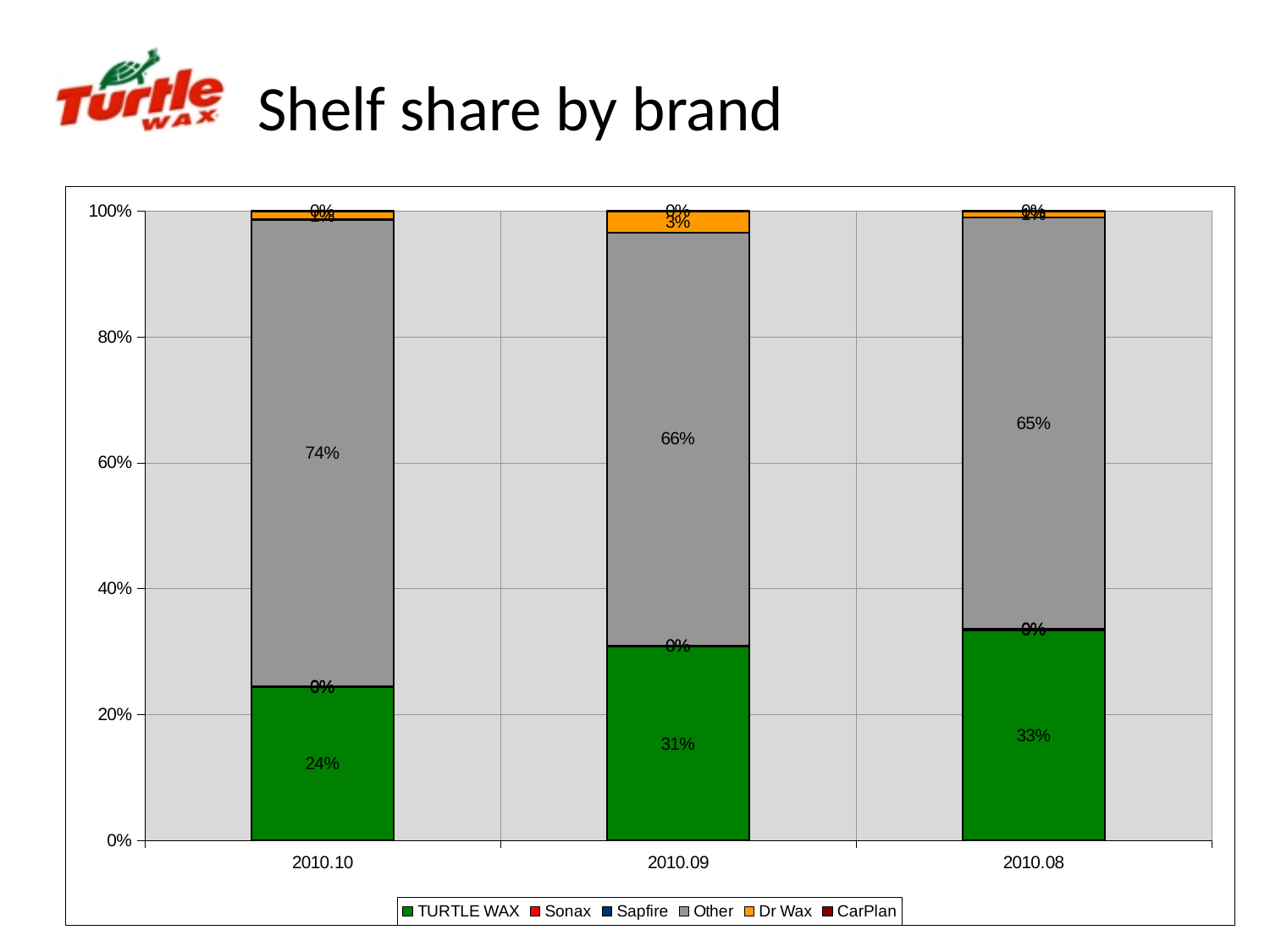
What is the title of the slide? Shelf share by brand What is the shelf share for TURTLE WAX in 2010.08? 33% What is the shelf share for TURTLE WAX in 2010.10? 24% What is the difference between the Other share in 2010.10 and in 2010.08? 9% Which is larger, the TURTLE WAX share in 2010.09 or in 2010.10? 2010.09 What is the shelf share for Other in 2010.09? 66% What is the shelf share for Dr Wax in 2010.09? 3% What kind of chart is shown on the slide? Stacked bar chart How many periods are shown on the x axis? 3 In which period is the Other shelf share lowest? 2010.08 In which period is the TURTLE WAX shelf share highest? 2010.08 How many series does the legend list? 6